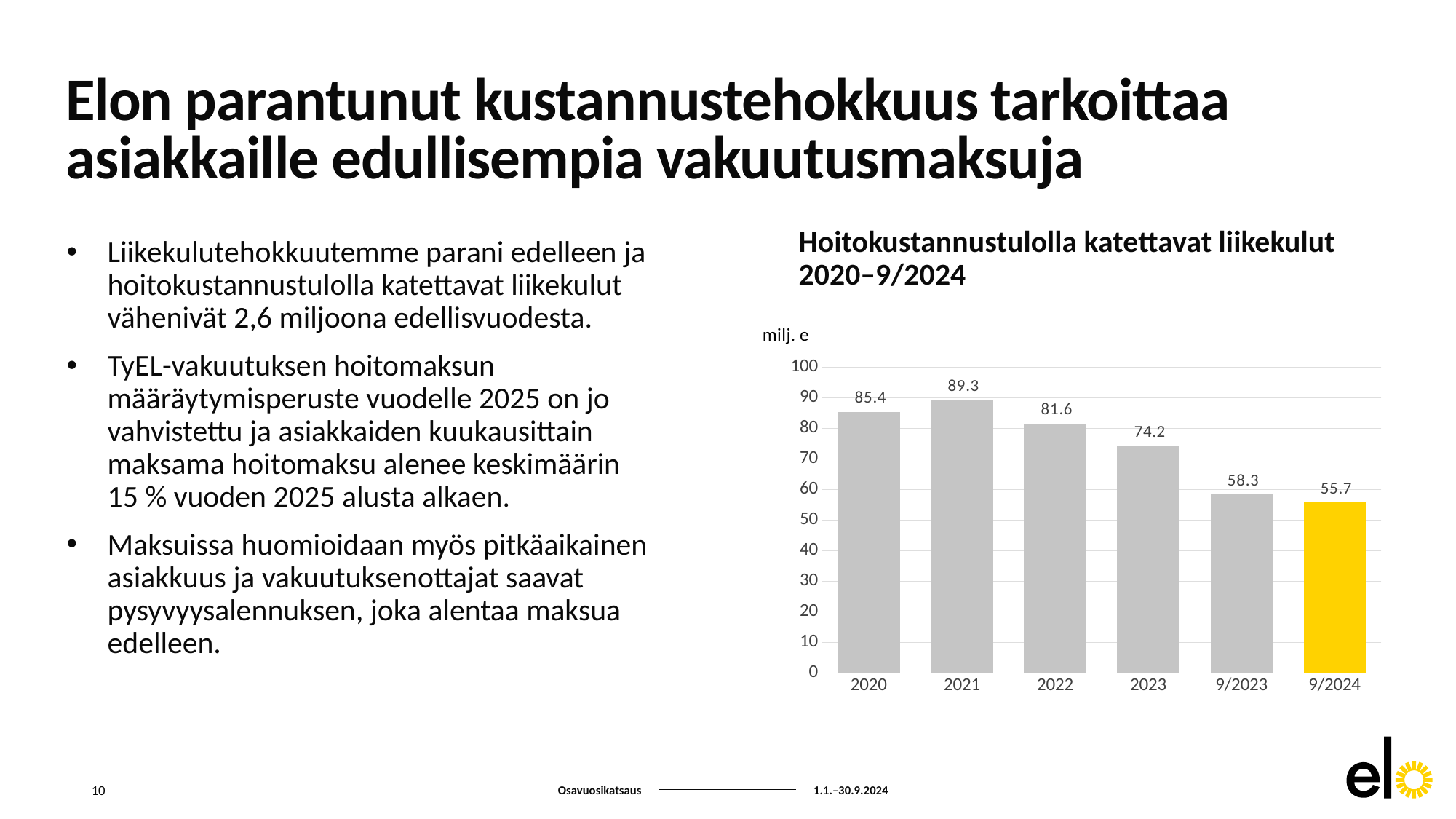
What unit is shown on the chart's axis label? milj. e Which category has the highest value? 2021 What is the value for 9/2024? 55.7 Is the value for 2023 greater or less than 70? greater Which category has the lowest value? 9/2024 What is the difference between the values for 2021 and 2022? 7.7 Which is larger, the value for 2020 or the value for 2022? 2020 What is the value for 2023? 74.2 How many categories are shown on the x axis? 6 What kind of chart is shown? bar chart What is the difference between the values for 9/2023 and 9/2024? 2.6 What is the value for 2021? 89.3